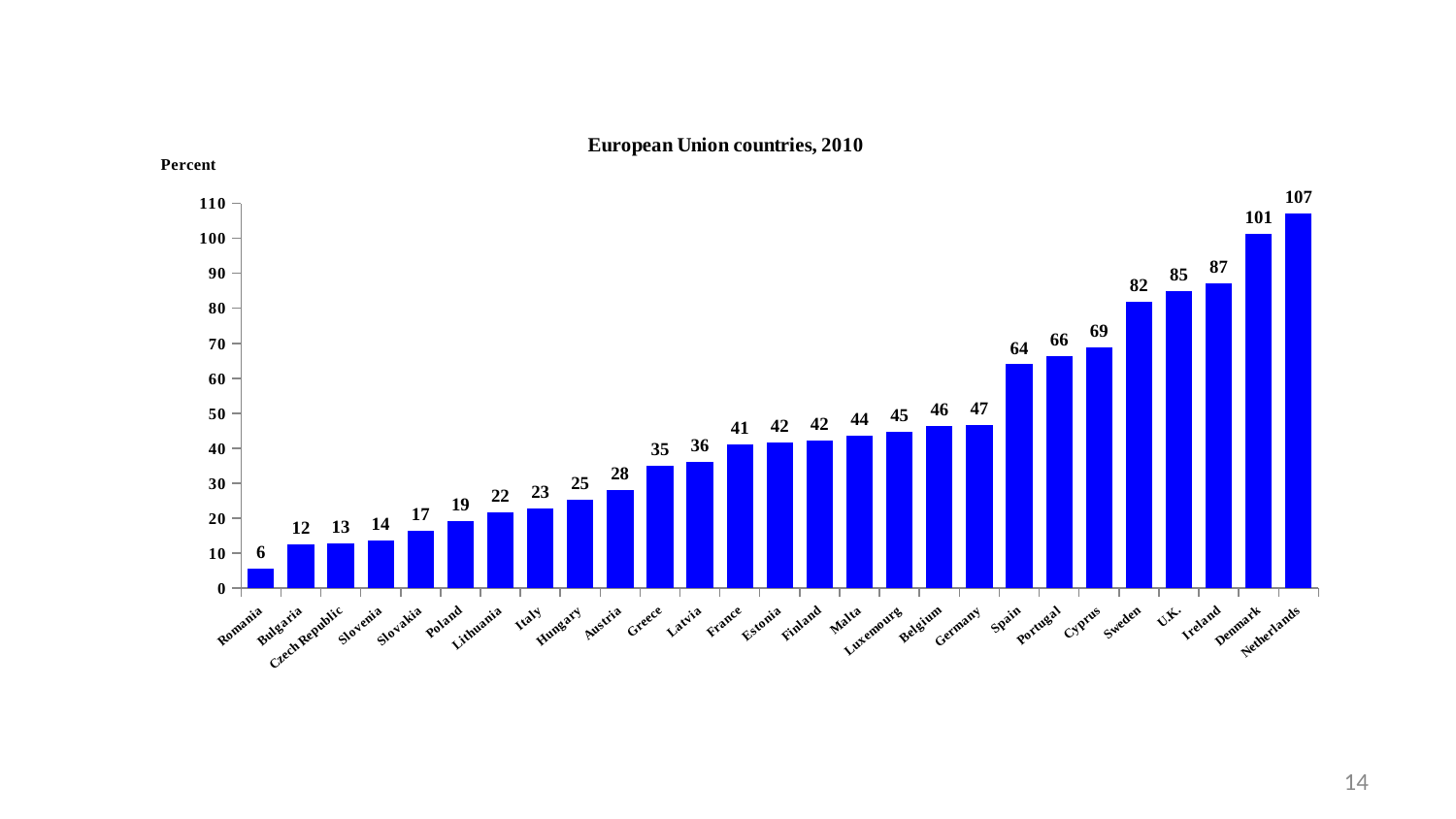
Is the value for Portugal greater or less than 60? greater What is the difference between the values for Netherlands and Denmark? 6 Which country has the highest value? Netherlands What is the difference between the values for Spain and Greece? 29 Which country has the lowest value? Romania What is the title of the chart? European Union countries, 2010 What kind of chart is this? Bar chart How many countries are shown in the chart? 27 What is the value for Poland? 19 What is the value for Germany? 47 What is the value for Sweden? 82 Which has a larger value, Ireland or Cyprus? Ireland